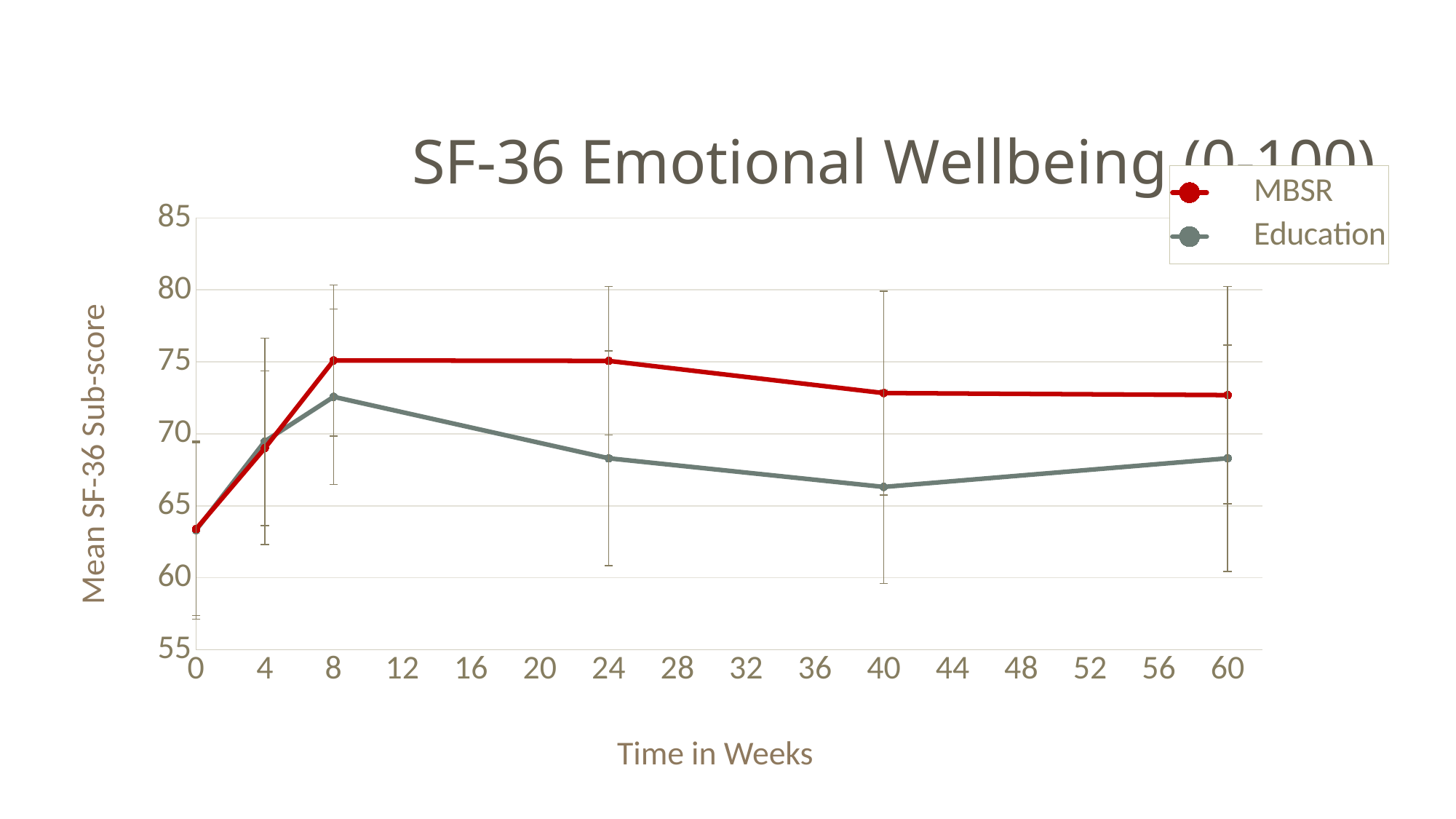
Is the Education value at week 40 greater or less than 70? less Is the MBSR value at week 40 greater or less than 75? less What kind of chart is shown on the slide? line chart At which week is the MBSR series at its lowest value? 0 How many series does the legend list? 2 Does the Education series rise or fall between week 8 and week 40? fall Is the MBSR value at week 8 greater or less than 70? greater At week 40, which series has the higher value, MBSR or Education? MBSR At which week does the Education series reach its highest value? 8 Which series is drawn in red? MBSR What is the x-axis title of the chart? Time in Weeks